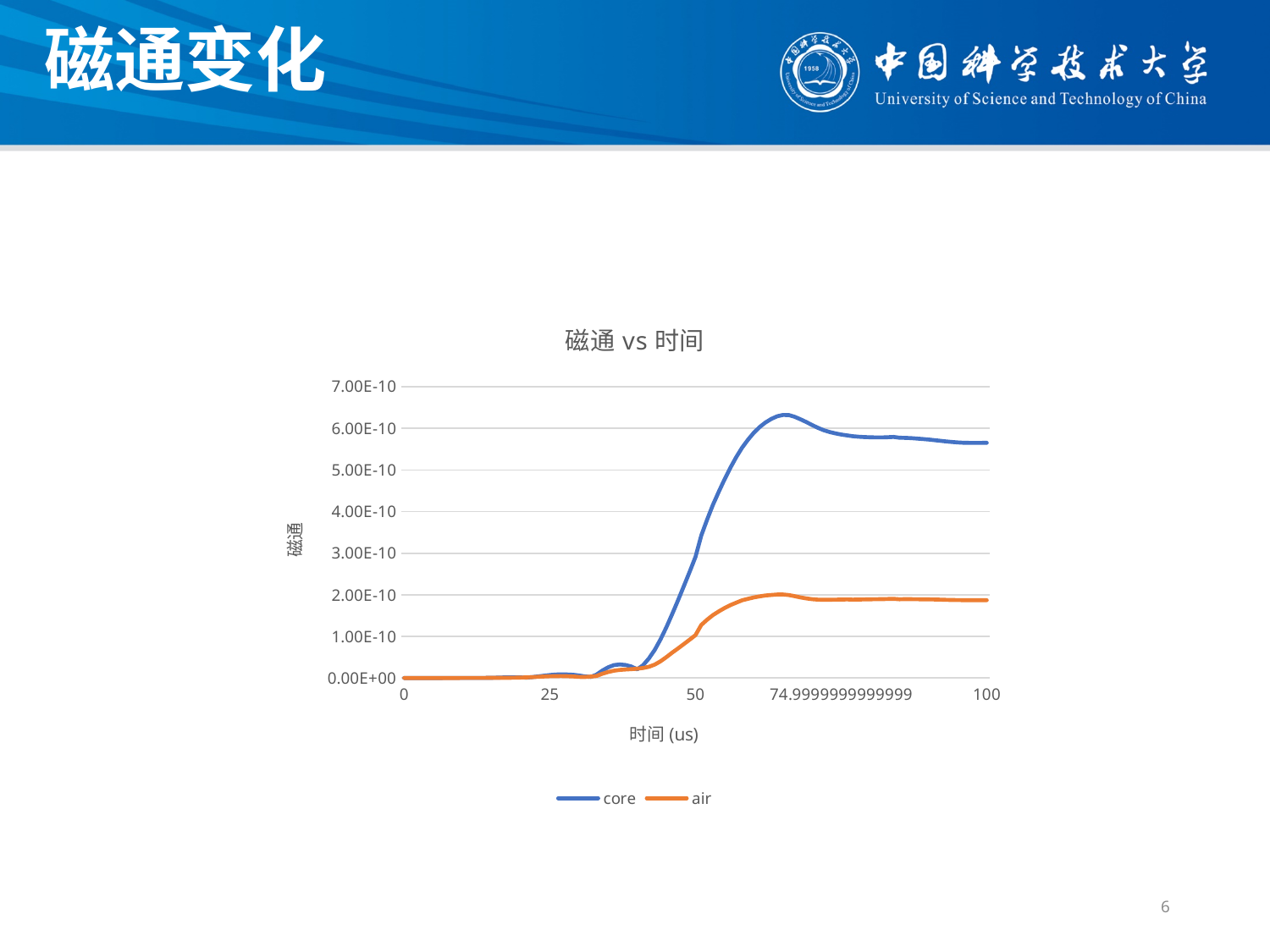
Is the value for air at time 100 greater or less than 3.00E-10? less What kind of chart is shown on the slide? line chart Is the peak value of the core series greater or less than 6.00E-10? greater Is the value for core at time 25 greater or less than 1.00E-10? less At time 100, which series has the larger value, core or air? core Which series reaches the higher peak value, core or air? core What is the label of the x axis? 时间 (us) What is the title of the chart? 磁通 vs 时间 How many series does the legend list? 2 Overall, does the core series rise or fall from time 0 to time 100? rise